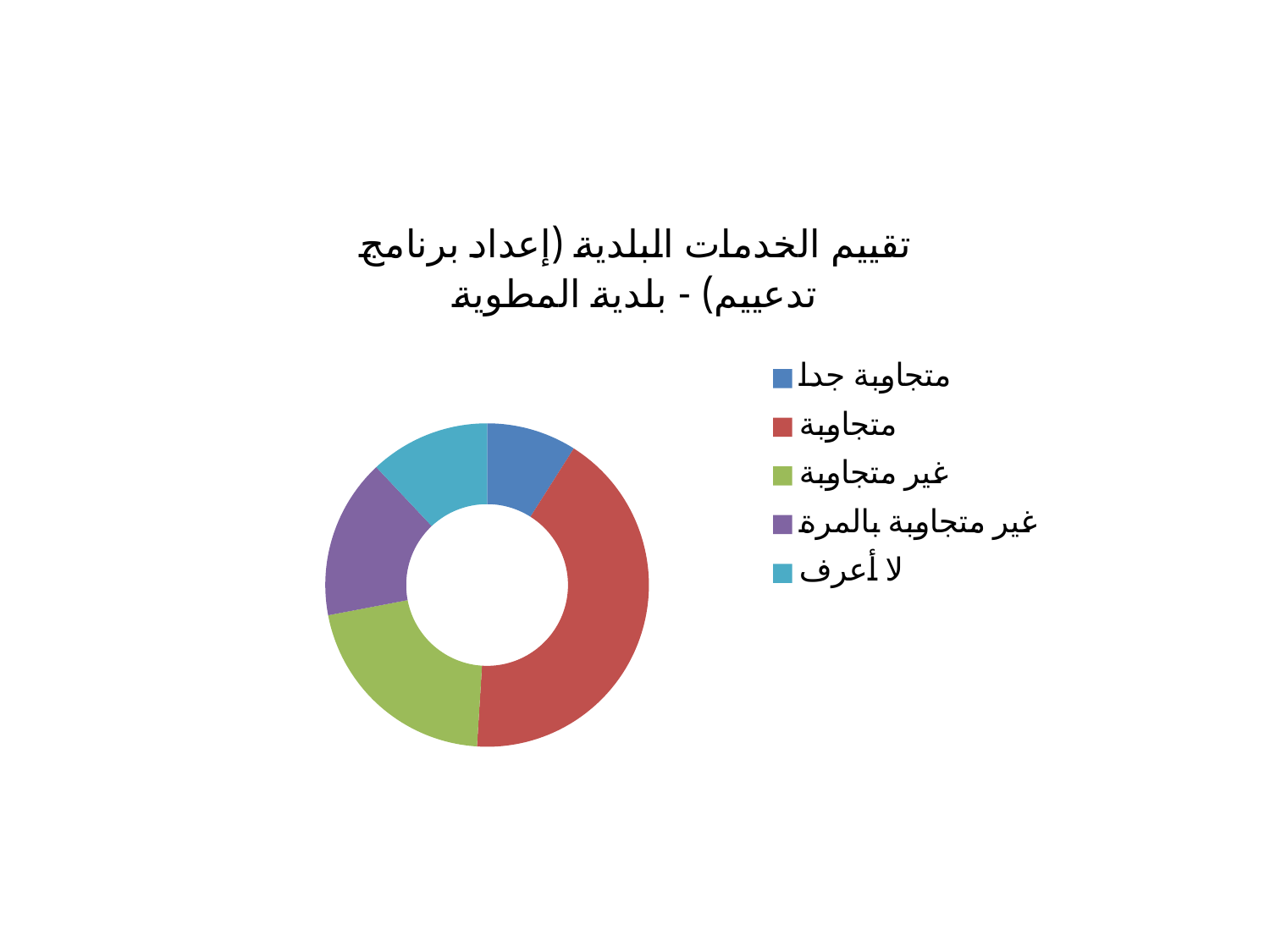
Which category has the largest share of the doughnut chart? متجاوبة Which is larger, the share for متجاوبة or the share for غير متجاوبة? متجاوبة What is the title of the chart? تقييم الخدمات البلدية (إعداد برنامج تدعييم) - بلدية المطوية Which category is shown in red in the chart? متجاوبة Which is larger, the share for متجاوبة or the share for لا أعرف? متجاوبة Which is larger, the share for غير متجاوبة or the share for متجاوبة جدا? غير متجاوبة How many categories does the legend of the chart list? 5 What kind of chart is shown on the slide? Doughnut chart